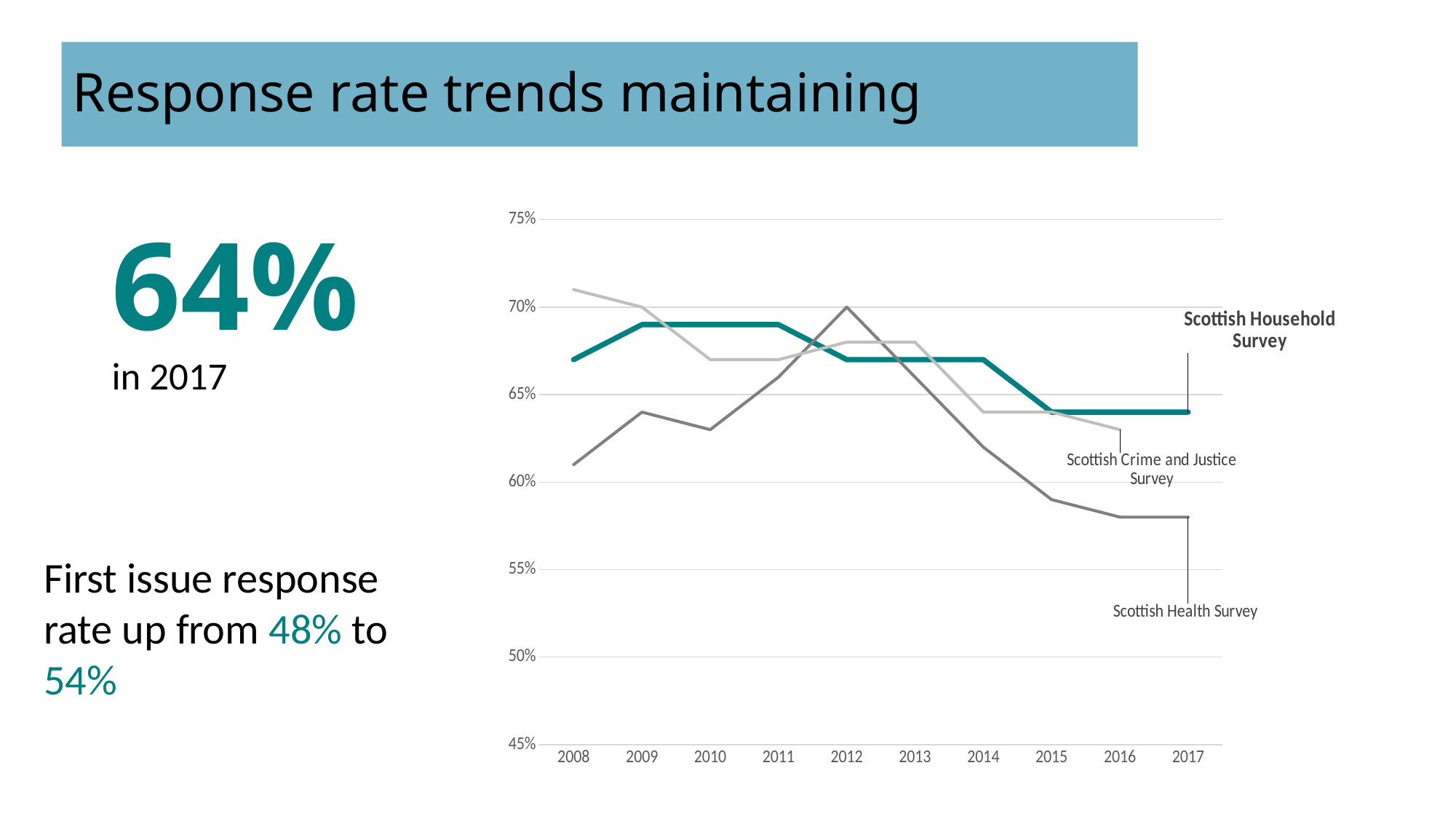
Is the Scottish Health Survey response rate in 2017 greater or less than 60%? less What is the first year shown on the x axis of the chart? 2008 Which survey has the highest response rate in 2008? Scottish Crime and Justice Survey Which survey has the lowest response rate in 2017? Scottish Health Survey Is the Scottish Household Survey response rate in 2011 greater or less than 65%? greater Does the Scottish Health Survey response rate rise or fall from 2012 to 2017? fall What is the Scottish Household Survey response rate in 2017? 64% Which survey has the highest response rate in 2017? Scottish Household Survey Is the Scottish Health Survey response rate in 2008 greater or less than 65%? less How many years are shown on the x axis of the chart? 10 What type of chart is shown on the slide? Line chart How many survey series are plotted on the chart? 3